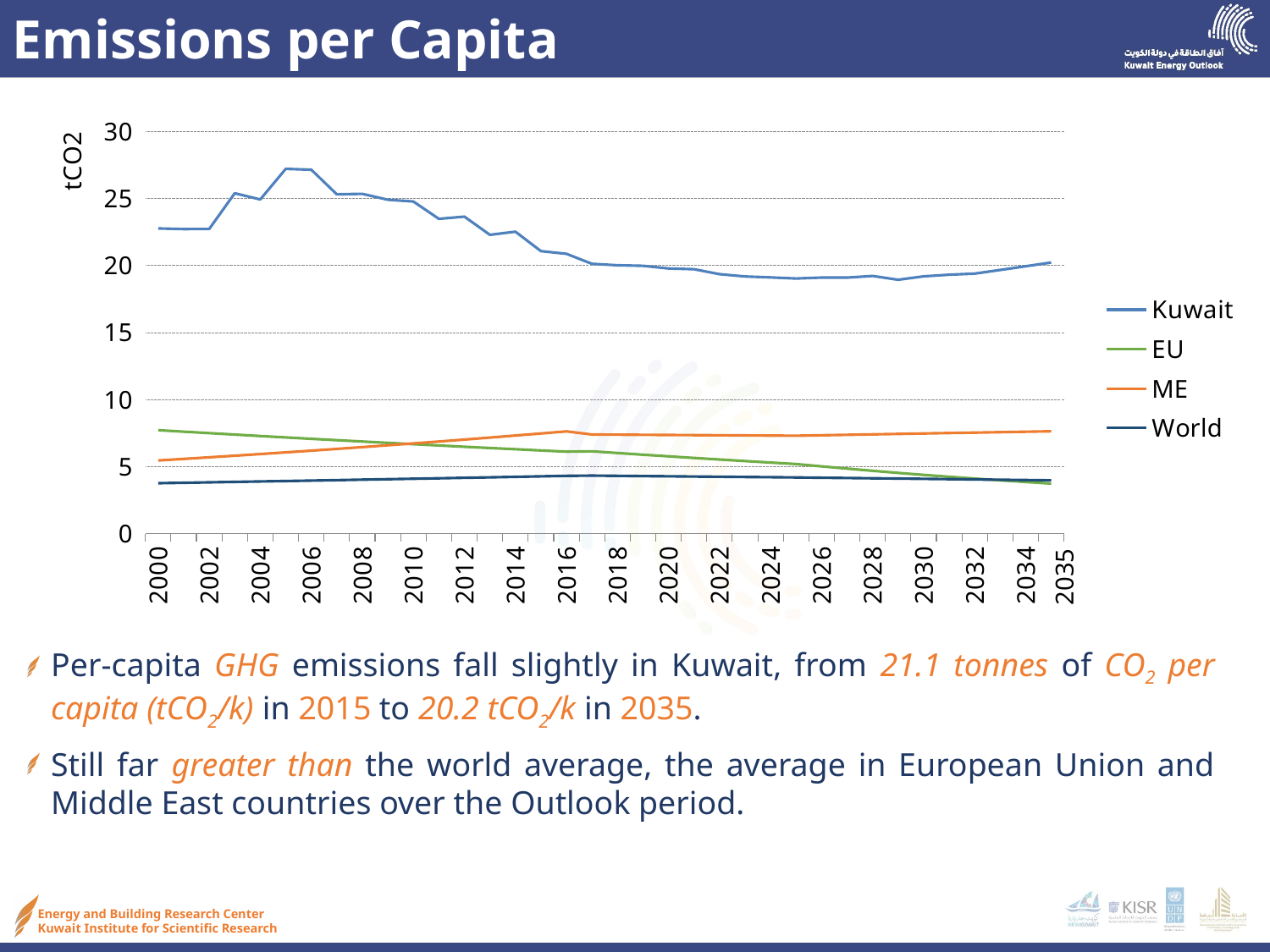
What is the label on the vertical axis? tCO2 How many series does the legend list? 4 Which series are listed in the legend? Kuwait, EU, ME, World According to the slide, what is Kuwait's per-capita emissions value in 2035? 20.2 tCO2/k In 2000, which is higher, EU or ME? EU Is the value for World in 2035 greater or less than 5? less Is the value for Kuwait in 2005 greater or less than 25? greater Which series has the highest emissions per capita throughout the period? Kuwait What kind of chart is shown on the slide? Line chart Is the value for Kuwait in 2035 greater or less than 25? less Which series has the lowest emissions per capita in 2000? World Does the EU line rise or fall from 2000 to 2035? Fall